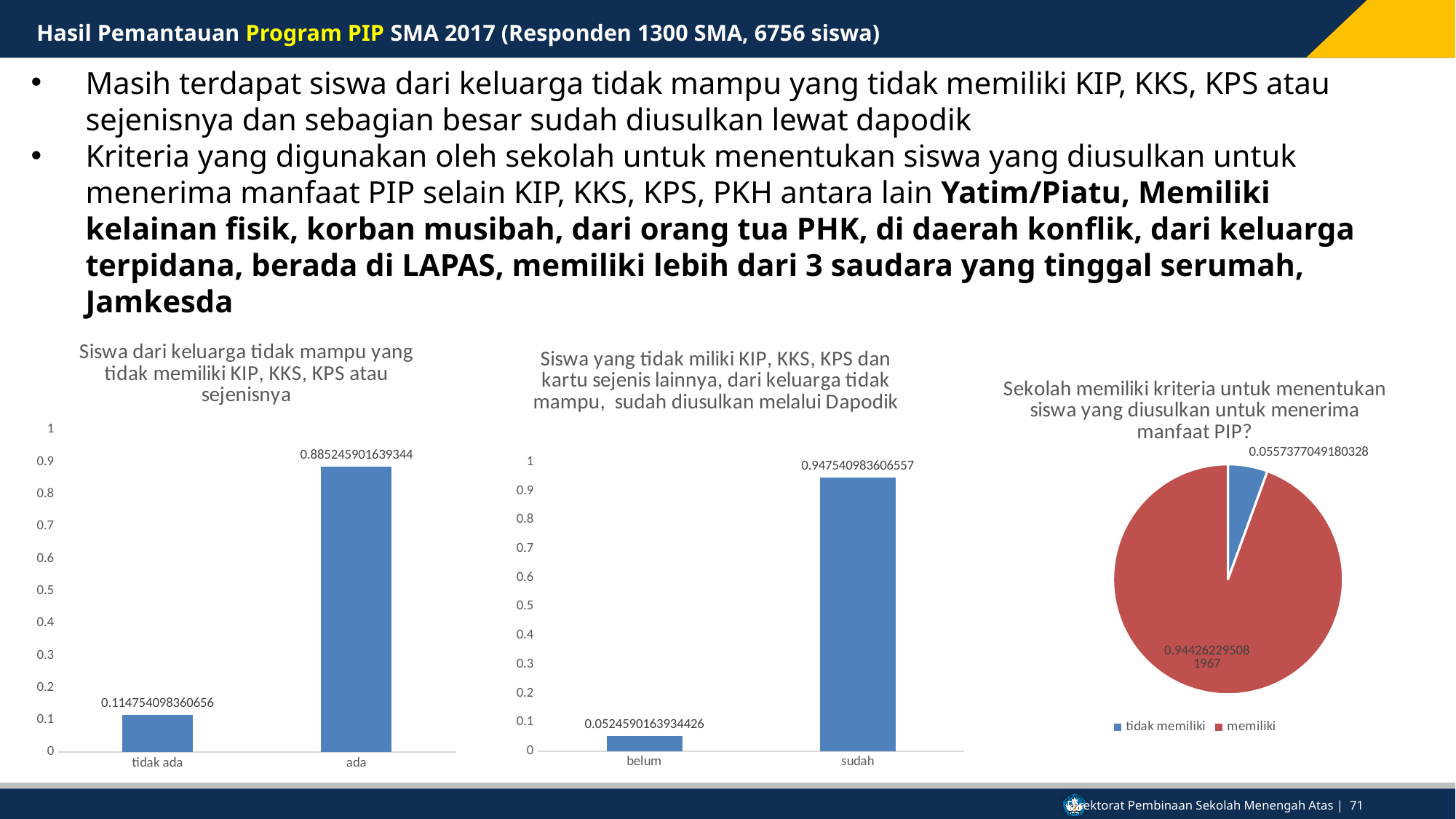
In the left chart 'Siswa dari keluarga tidak mampu yang tidak memiliki KIP, KKS, KPS atau sejenisnya', what is the value for 'tidak ada'? 0.114754098360656 What kind of chart is the right chart 'Sekolah memiliki kriteria untuk menentukan siswa yang diusulkan untuk menerima manfaat PIP?'? pie chart In the left chart 'Siswa dari keluarga tidak mampu yang tidak memiliki KIP, KKS, KPS atau sejenisnya', what is the value for 'ada'? 0.885245901639344 In the left bar chart, is the value for 'tidak ada' greater or less than 0.2? less In the middle chart 'Siswa yang tidak miliki KIP, KKS, KPS dan kartu sejenis lainnya, dari keluarga tidak mampu, sudah diusulkan melalui Dapodik', what is the value for 'sudah'? 0.947540983606557 In the left bar chart, which category has the higher value, 'tidak ada' or 'ada'? ada In the middle chart 'Siswa yang tidak miliki KIP, KKS, KPS dan kartu sejenis lainnya, dari keluarga tidak mampu, sudah diusulkan melalui Dapodik', what is the value for 'belum'? 0.0524590163934426 In the middle bar chart, is the value for 'sudah' greater or less than 0.9? greater In the middle bar chart, which category has the lowest value? belum In the right pie chart, which slice is larger, 'tidak memiliki' or 'memiliki'? memiliki In the right pie chart 'Sekolah memiliki kriteria untuk menentukan siswa yang diusulkan untuk menerima manfaat PIP?', what is the value for 'tidak memiliki'? 0.0557377049180328 How many categories are shown in the middle bar chart? 2